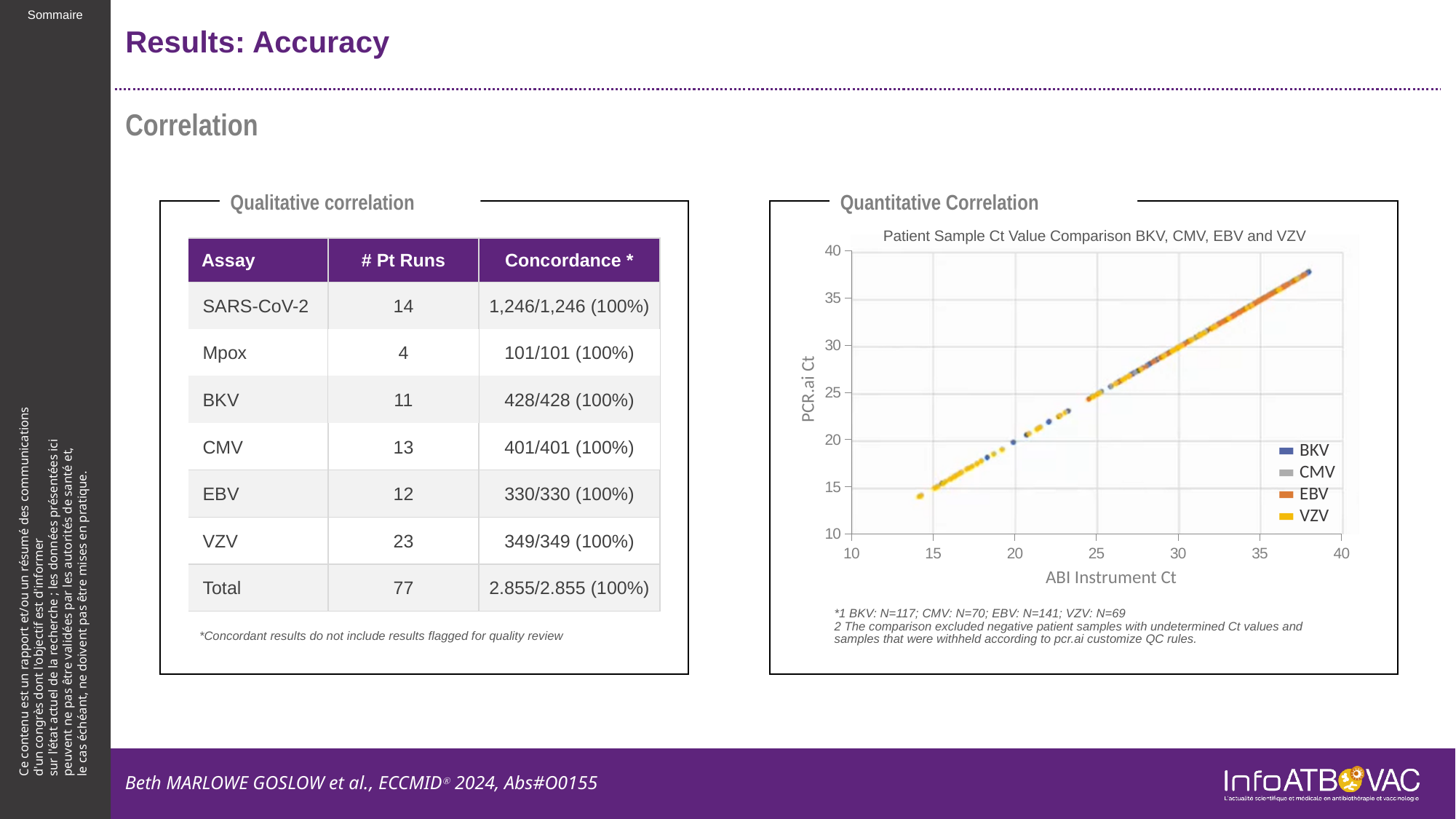
Which series are listed in the legend of the scatter chart? BKV, CMV, EBV, VZV Do the points in the scatter chart rise or fall as ABI Instrument Ct increases? rise What kind of chart is shown under Quantitative Correlation? scatter chart How many series does the legend of the scatter chart list? 4 What is the label of the x axis of the scatter chart? ABI Instrument Ct What is the title of the scatter chart? Patient Sample Ct Value Comparison BKV, CMV, EBV and VZV